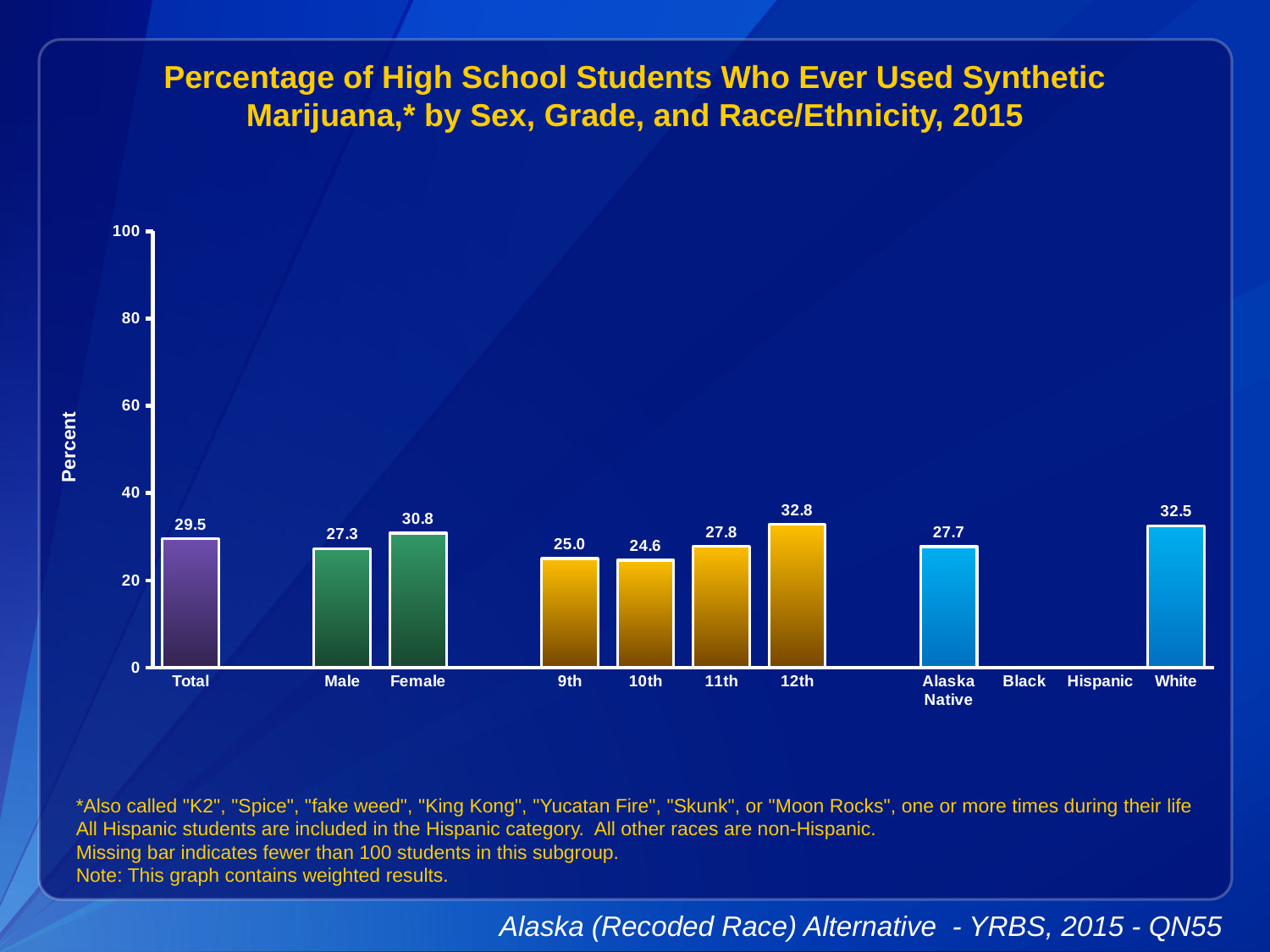
What is the value for Total? 29.5 How many bars are plotted on the chart? 9 What is the value for Female? 30.8 Which category has the highest value? 12th Which is larger, the value for White or the value for Alaska Native? White Which category has the lowest value among the bars shown? 10th What is the value for Alaska Native? 27.7 What is the value for 10th grade? 24.6 Which race/ethnicity categories have no bar shown? Black and Hispanic What kind of chart is shown? bar chart Is the value for 12th grade greater or less than 40? less What is the difference between the Female and Male values? 3.5